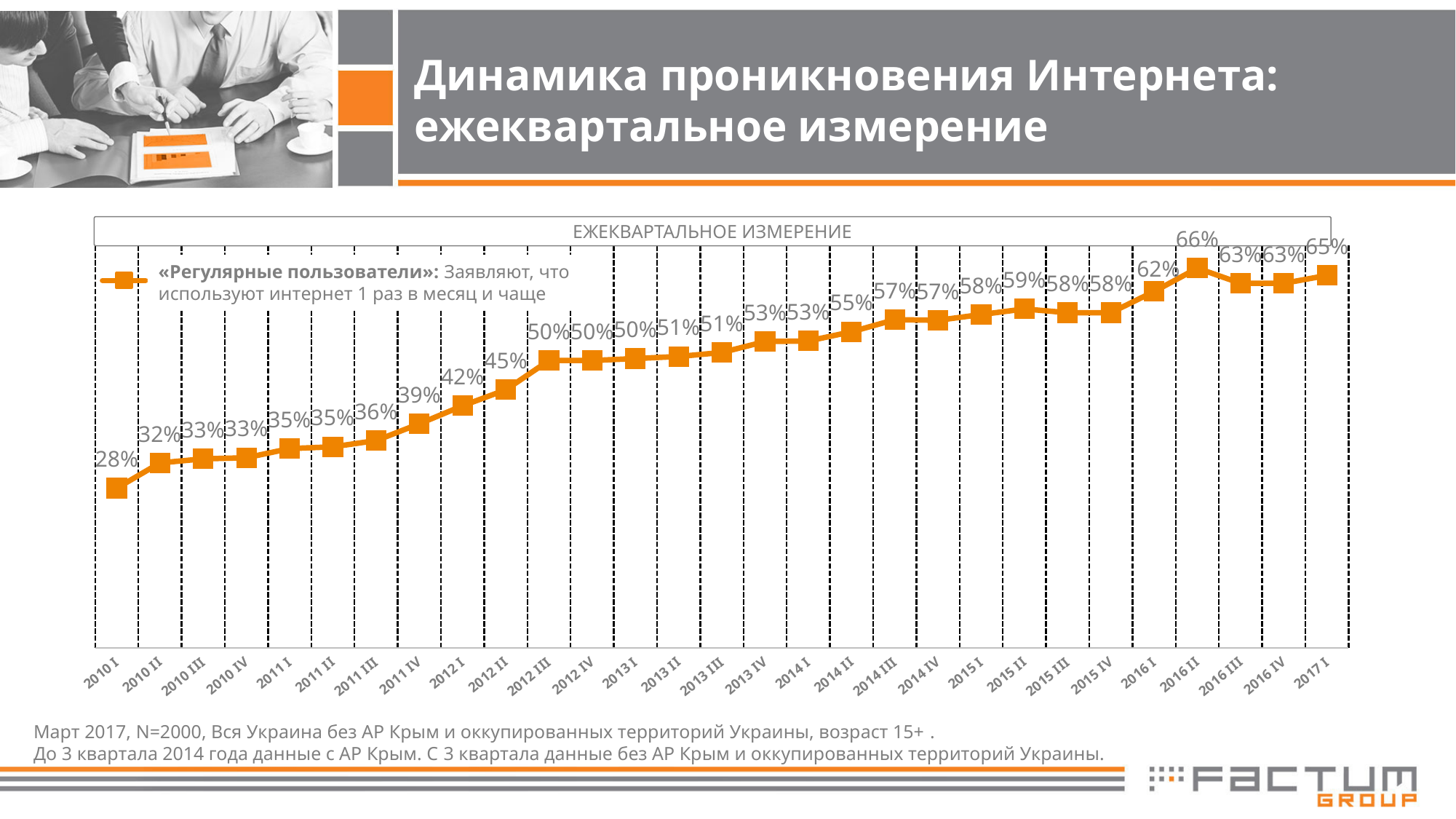
What is the difference between the values for 2016 II and 2016 III? 3% What type of chart is shown on the slide? line chart What is the value for 2010 I? 28% What is the value for 2015 II? 59% Which quarter has the lowest value? 2010 I What is the title of the chart? ЕЖЕКВАРТАЛЬНОЕ ИЗМЕРЕНИЕ What is the value for 2012 III? 50% Which quarter has the highest value? 2016 II What is the value for 2017 I? 65% How many quarters are plotted on the x axis? 29 Which is larger, the value for 2011 IV or the value for 2012 I? 2012 I What is the difference between the values for 2017 I and 2010 I? 37%